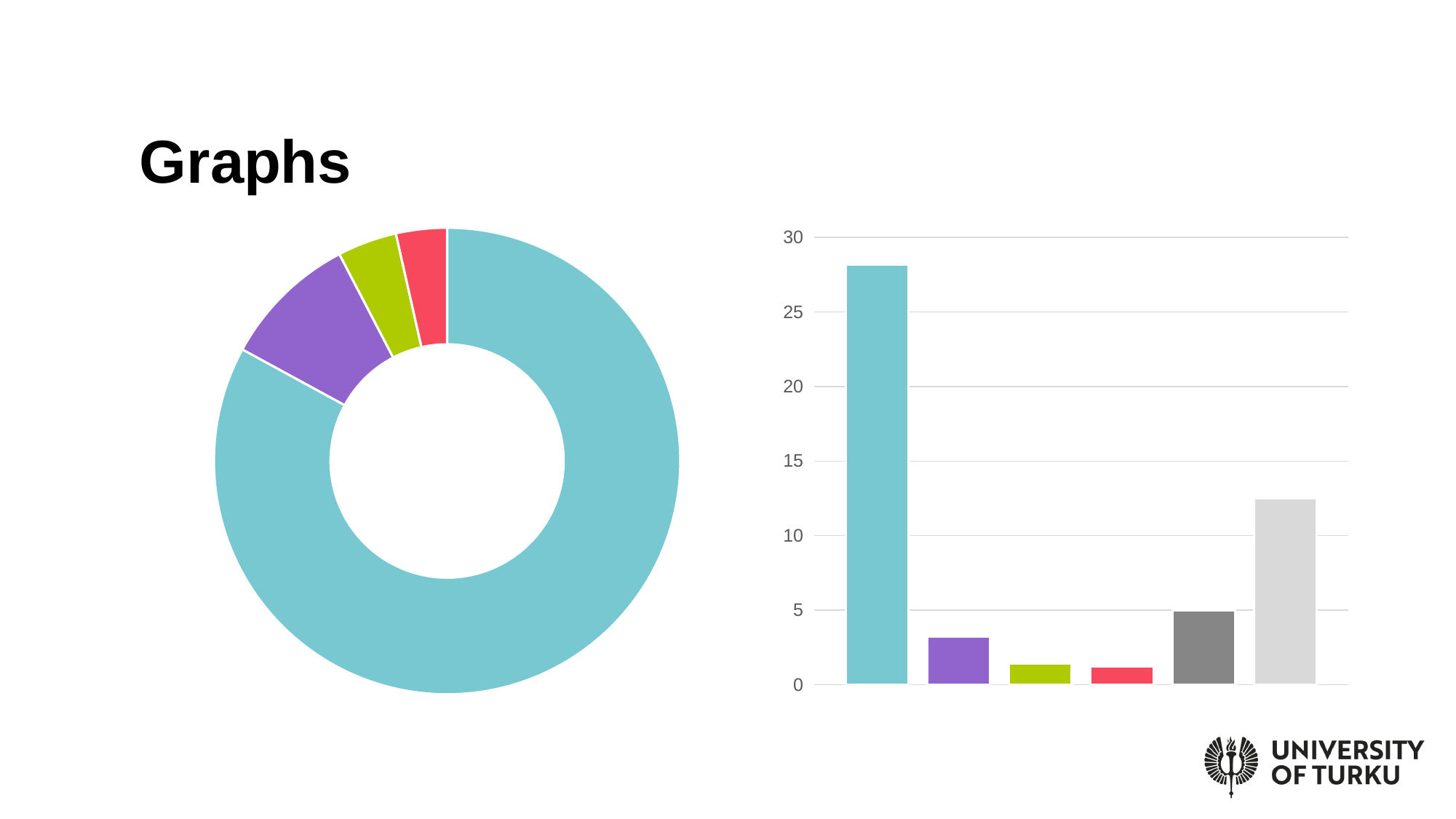
In the bar chart on the right, is the value of the purple bar greater or less than 5? less In the bar chart on the right, which is larger: the first (teal) bar or the last (light grey) bar? the first (teal) bar In the donut chart on the left, how many slices are there? 4 In the bar chart on the right, is the value of the last (light grey) bar greater or less than 10? greater What kind of chart is the chart on the right side of the slide? bar chart In the donut chart on the left, which colour slice is the largest? teal What is the title of the slide? Graphs What kind of chart is the chart on the left side of the slide? donut (pie) chart In the bar chart on the right, which is larger: the purple bar or the last (light grey) bar? the last (light grey) bar In the bar chart on the right, which bar is the tallest? the first (teal) bar In the bar chart on the right, is the value of the first (teal) bar greater or less than 25? greater In the bar chart on the right, how many bars are plotted? 6